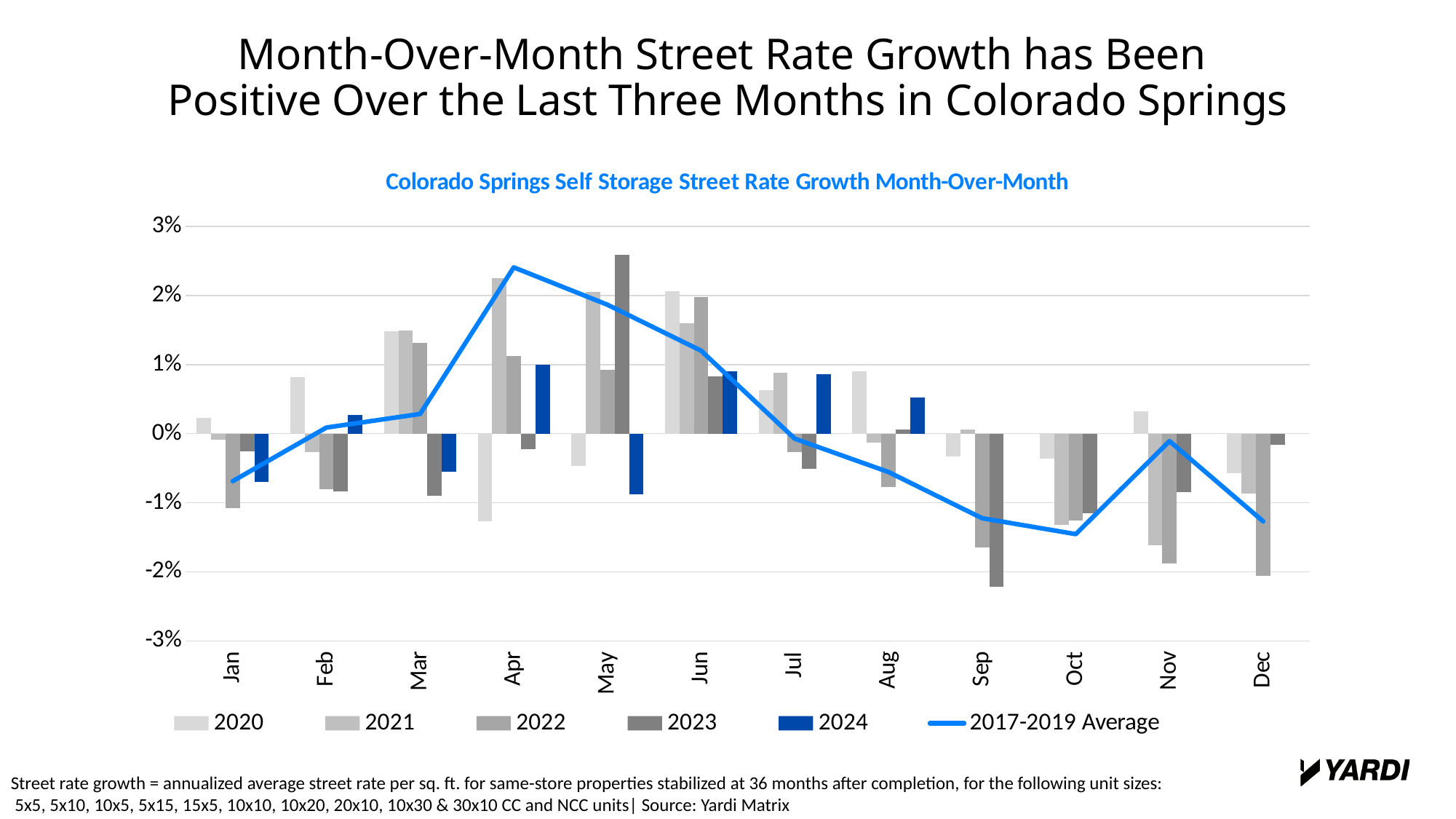
Is the 2023 value for May greater or less than 2%? greater How many months are shown along the x axis? 12 Which is larger, the 2024 value for Jan or the 2024 value for Apr? Apr How many series does the legend list? 6 Is the 2024 value for Apr greater or less than 0.5%? greater In which month does the 2017-2019 Average line reach its lowest value? Oct Is the 2024 value for May greater or less than -0.5%? less For how many months is a 2024 bar plotted? 8 What kind of chart is shown on the slide? A bar chart combined with a line Does the 2017-2019 Average line rise or fall from Apr to Oct? fall In which month does the 2017-2019 Average line reach its highest value? Apr